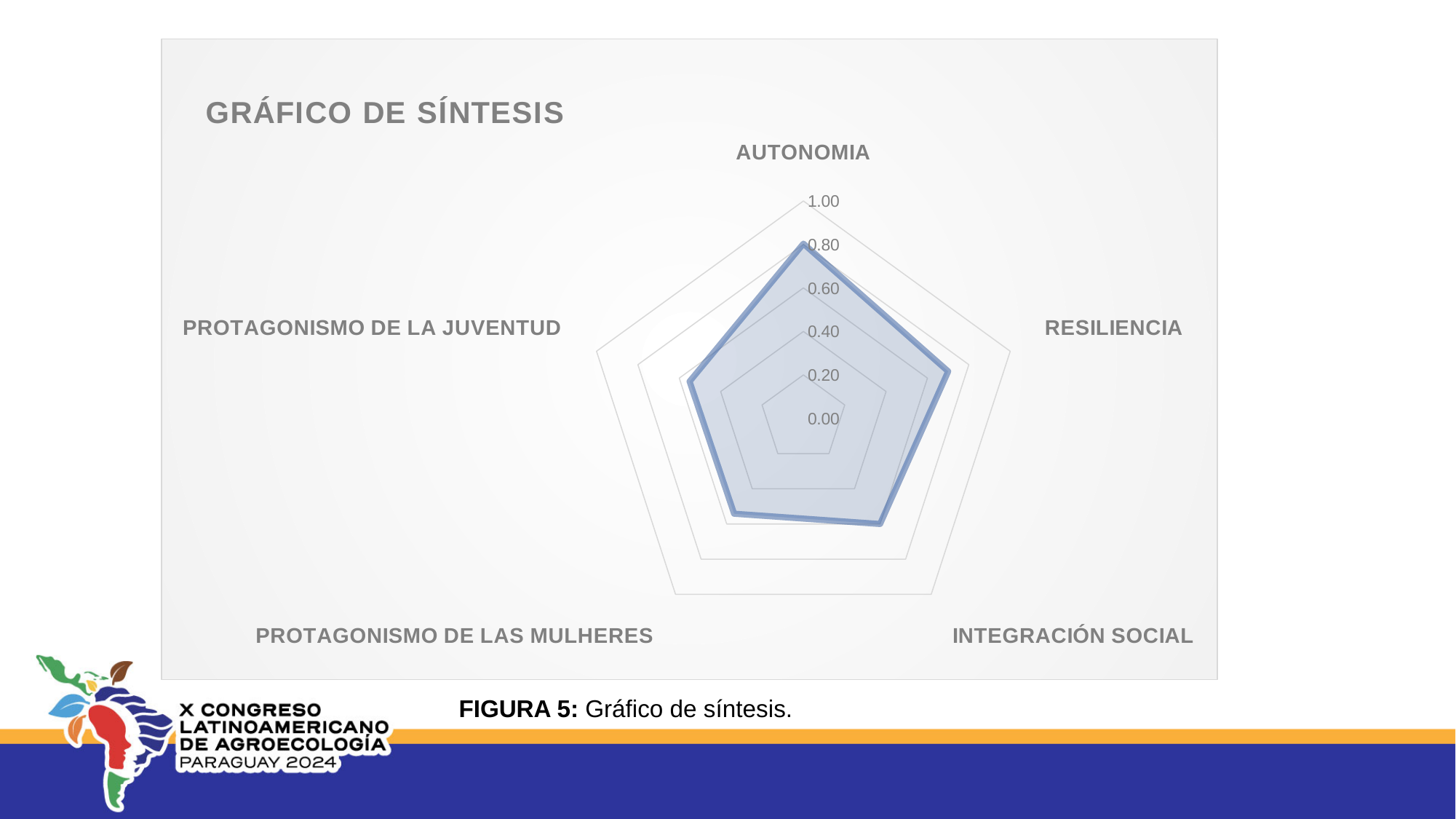
Is the value for PROTAGONISMO DE LAS MULHERES greater or less than 1.00? less Is the value for AUTONOMIA greater or less than 0.60? greater What kind of chart is shown on the slide? Radar chart What is the title of the chart? GRÁFICO DE SÍNTESIS What is the maximum value shown on the chart's axis scale? 1.00 Which is larger, the value for AUTONOMIA or the value for PROTAGONISMO DE LA JUVENTUD? AUTONOMIA Which category has the highest value in the chart? AUTONOMIA Is the value for INTEGRACIÓN SOCIAL greater or less than 0.40? greater How many categories (axes) does the radar chart have? 5